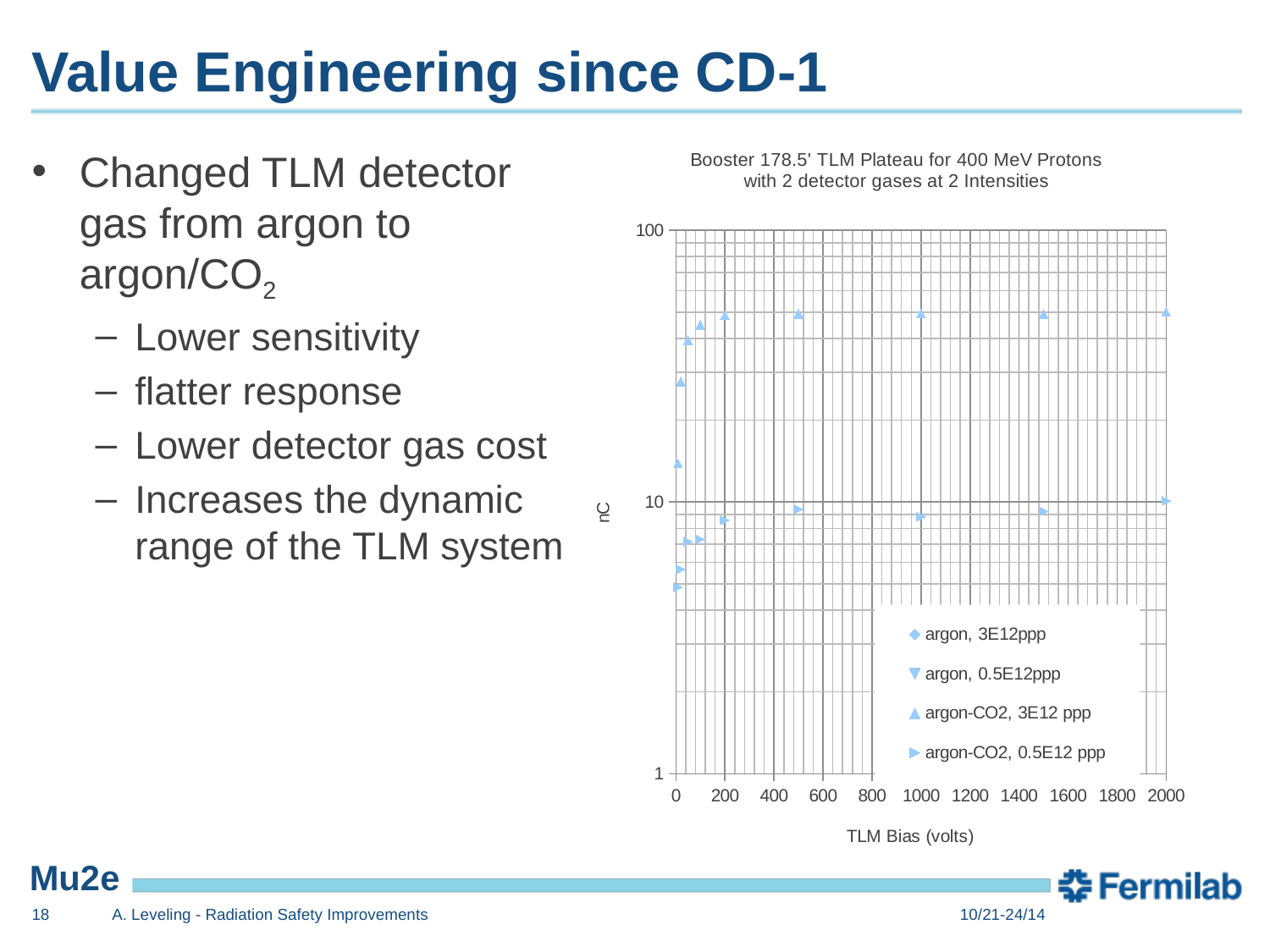
What is the label of the chart's x axis? TLM Bias (volts) How many series does the chart's legend list? 4 What is the title of the chart? Booster 178.5' TLM Plateau for 400 MeV Protons with 2 detector gases at 2 Intensities Does the argon-CO2, 0.5E12 ppp series rise or fall as TLM Bias increases from 0 to 200 volts? rise Is the value for argon-CO2, 3E12 ppp at 1500 volts greater or less than 10? greater What kind of chart is shown on the slide? scatter chart Is the value for argon-CO2, 3E12 ppp at 2000 volts greater or less than 10? greater Is the value for argon-CO2, 3E12 ppp at 2000 volts greater or less than 100? less Does the argon-CO2, 3E12 ppp series rise or fall as TLM Bias increases from 0 to 200 volts? rise At 1000 volts, which series has the larger value: argon-CO2, 3E12 ppp or argon-CO2, 0.5E12 ppp? argon-CO2, 3E12 ppp